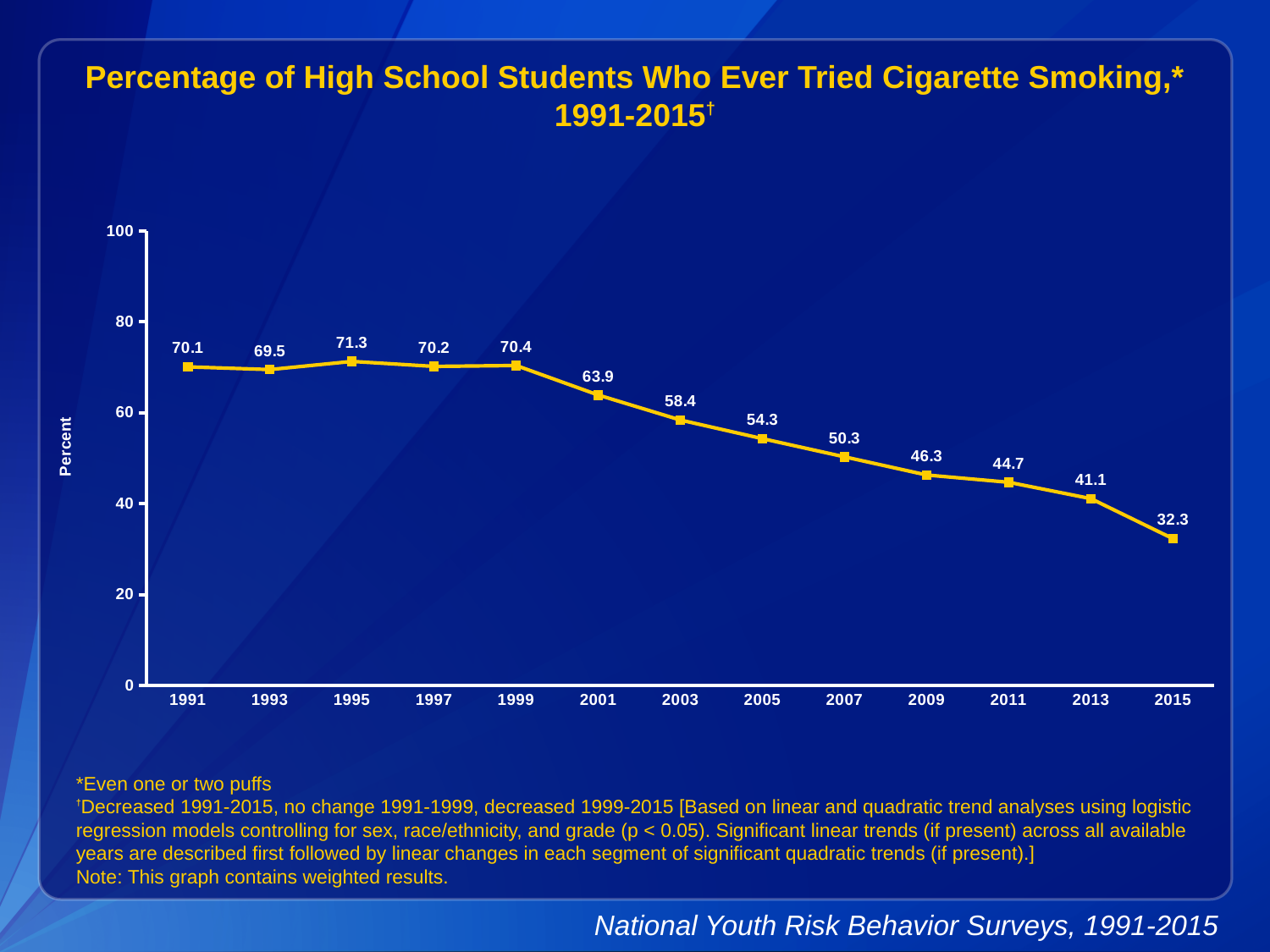
What is the difference between the 1991 value and the 2015 value? 37.8 Do the values rise or fall from 1999 to 2015? fall How many years are plotted on the x axis? 13 Is the value for 2007 greater or less than 60? less Which year has the lowest value on the chart? 2015 What kind of chart is shown on the slide? line chart Which year has the highest value on the chart? 1995 What percentage of high school students had ever tried cigarette smoking in 1991? 70.1 What is the value plotted for 2015? 32.3 What is the label on the y axis? Percent Which year has a larger value, 2001 or 2009? 2001 What is the value plotted for 2003? 58.4